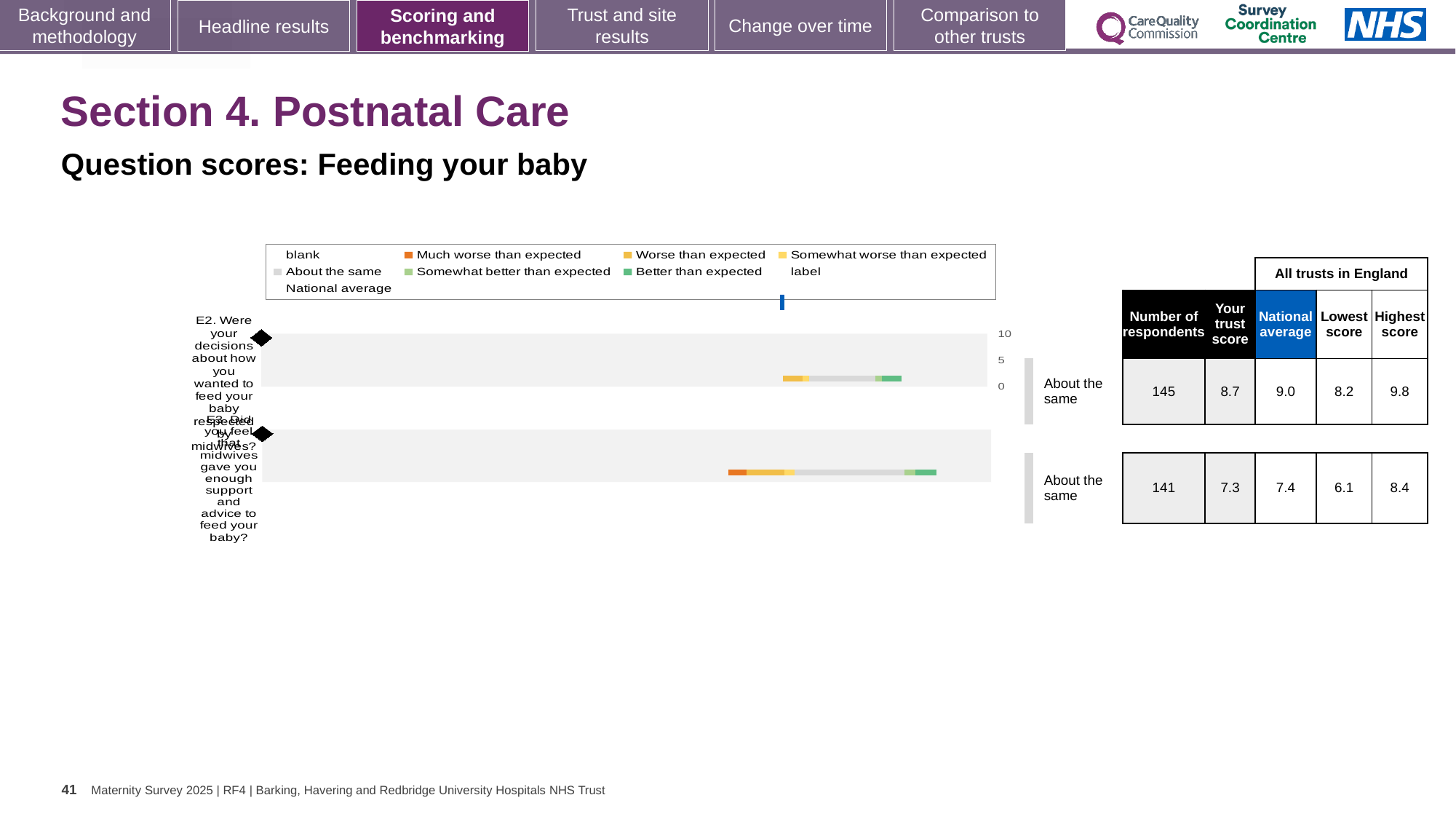
How many questions are plotted in the Feeding your baby chart? 2 What is the difference between the highest score and the lowest score for E3? 2.3 What kind of chart is used to show the question scores for Feeding your baby? bar chart What is the difference between the highest score and the lowest score for E2? 1.6 What is the subtitle of the chart on this slide? Question scores: Feeding your baby How many respondents answered question E2? 145 What benchmark category is shown for E3? About the same What is the national average for E3 (midwives gave you enough support and advice to feed your baby)? 7.4 In the Feeding your baby chart, which legend entry is shown in orange? Much worse than expected How much lower is the trust score for E2 than the national average for E2? 0.3 What is the trust score for E2 (decisions about how you wanted to feed your baby respected by midwives)? 8.7 Which question has the higher trust score, E2 or E3? E2